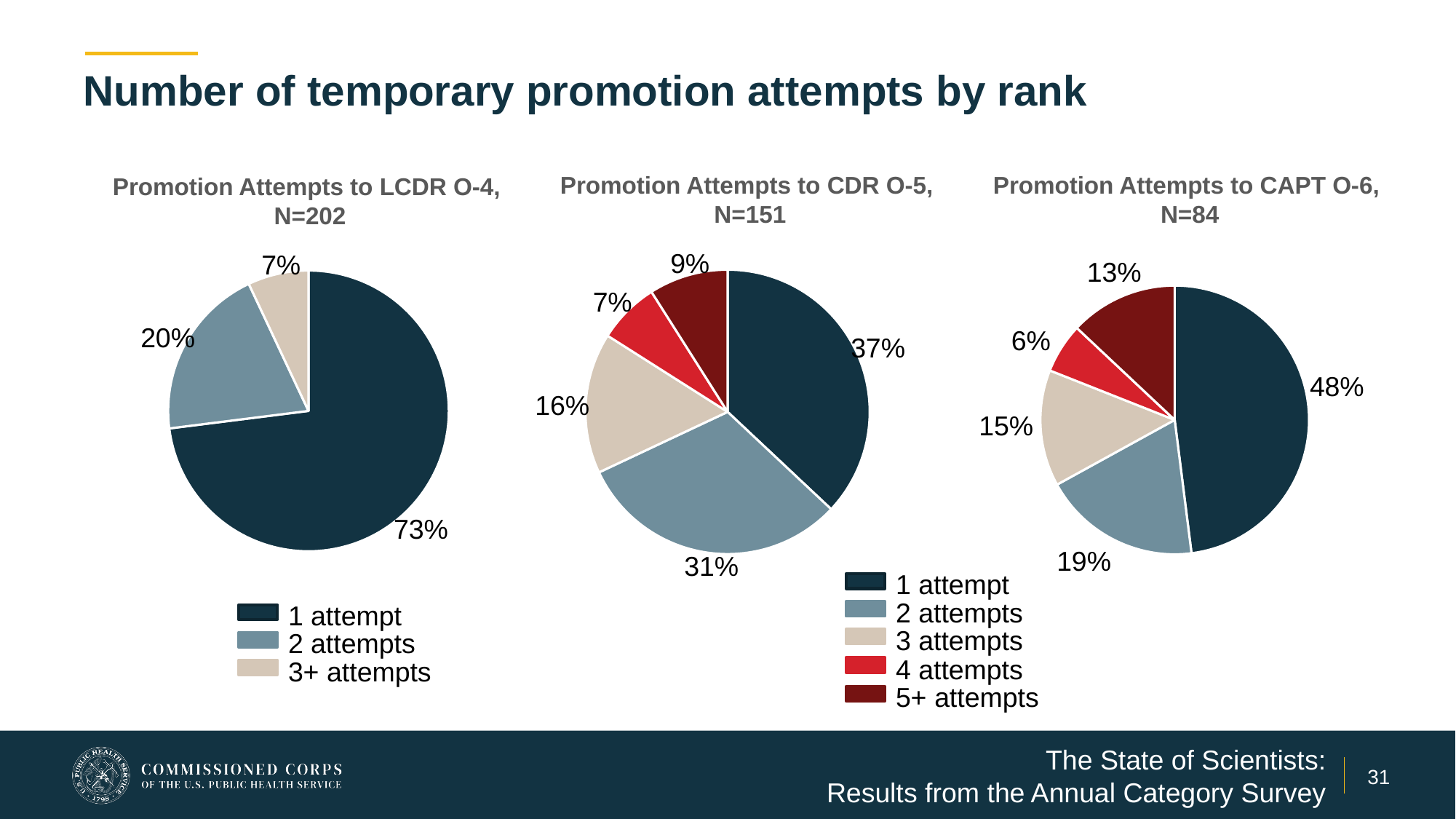
In the 'Promotion Attempts to CAPT O-6' chart, which is larger: the share for 2 attempts or the share for 5+ attempts? 2 attempts What type of chart is used for 'Promotion Attempts to CDR O-5'? Pie chart In the 'Promotion Attempts to CAPT O-6' chart, which category has the smallest slice? 4 attempts In the 'Promotion Attempts to CAPT O-6' chart, what share of respondents made 1 attempt? 48% In the 'Promotion Attempts to LCDR O-4' chart, what share of respondents made 1 attempt? 73% In the 'Promotion Attempts to CDR O-5' chart, what percentage made 3 attempts? 16% How many categories does the 'Promotion Attempts to CAPT O-6' chart show? 5 In the 'Promotion Attempts to LCDR O-4' chart, what percentage made 2 attempts? 20% In the 'Promotion Attempts to CDR O-5' chart, which category has the largest slice? 1 attempt In the 'Promotion Attempts to CDR O-5' chart, what is the difference in percentage points between 1 attempt and 2 attempts? 6 How many categories does the 'Promotion Attempts to LCDR O-4' chart show? 3 In the 'Promotion Attempts to CDR O-5' chart, what percentage made 5+ attempts? 9%